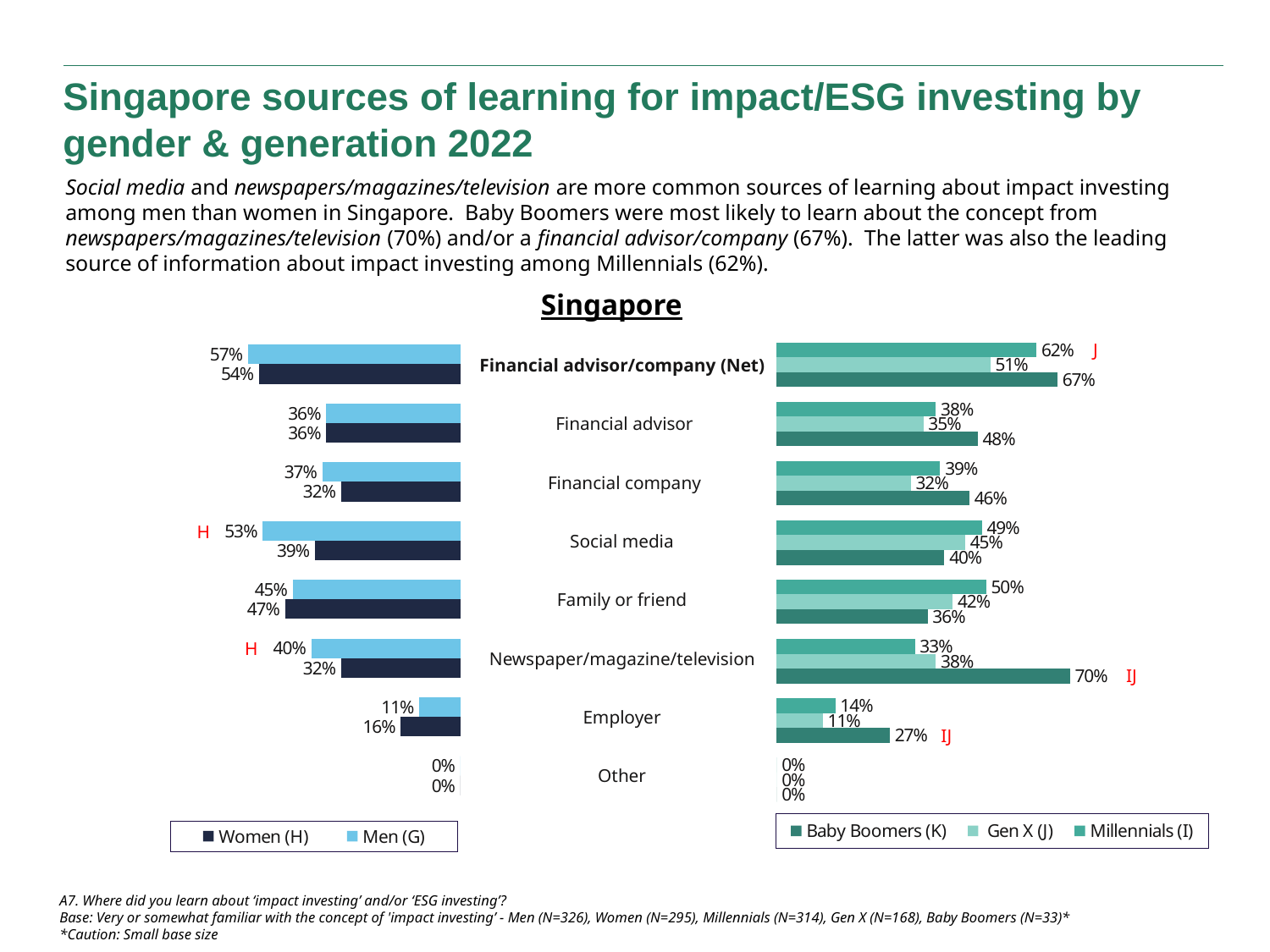
In the right (generation) chart, which generation has the highest value for Family or friend? Millennials In the left (gender) chart, which is larger for Family or friend, the value for women or the value for men? Women What type of chart is used on this slide? Bar chart In the right (generation) chart, what is the value for Gen X for Financial advisor/company (Net)? 51% In the left (gender) chart, which source has the highest value for men? Financial advisor/company (Net) How many series does the legend of the right (generation) chart list? 3 How many source categories are shown in the left (gender) chart? 8 In the left (gender) chart, what percentage of men learned about impact investing from social media? 53% In the right (generation) chart, what percentage of Baby Boomers learned from Newspaper/magazine/television? 70% In the left (gender) chart, what is the value for women for Employer? 16% In the right (generation) chart, what is the difference between Baby Boomers and Gen X for Employer? 16% In the left (gender) chart, what is the difference between men and women for Newspaper/magazine/television? 8%